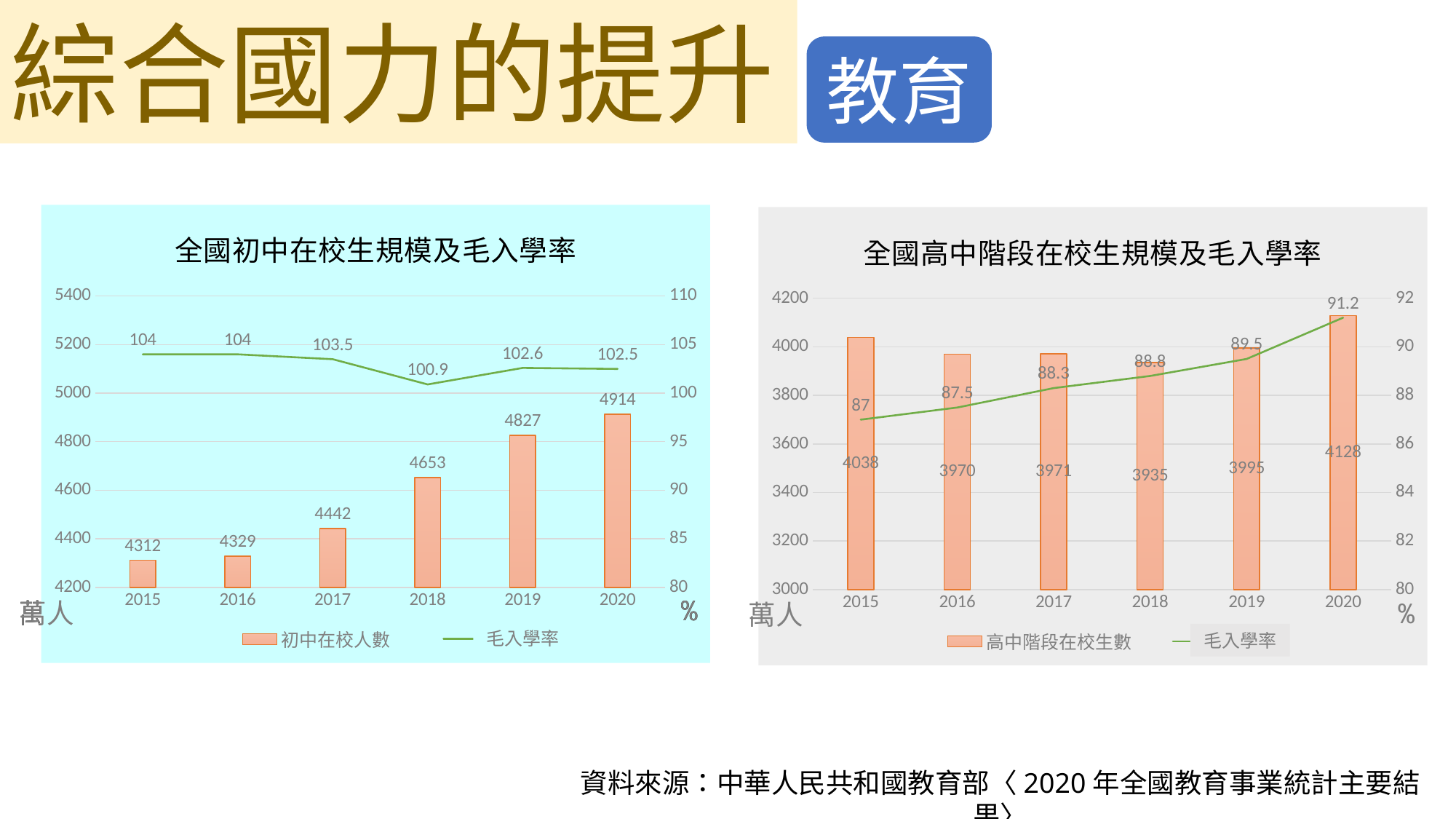
In the chart titled 全國初中在校生規模及毛入學率, what is the 毛入學率 for 2018? 100.9 In the chart titled 全國初中在校生規模及毛入學率, what is the value of 初中在校人數 for 2018? 4653 In the chart titled 全國初中在校生規模及毛入學率, which year has the highest 初中在校人數? 2020 In the chart titled 全國高中階段在校生規模及毛入學率, which year has the lowest 高中階段在校生數? 2018 In the chart titled 全國初中在校生規模及毛入學率, do the 初中在校人數 bars rise or fall from 2015 to 2020? rise In the chart titled 全國高中階段在校生規模及毛入學率, which is larger, the 高中階段在校生數 for 2015 or for 2019? 2015 In the chart titled 全國初中在校生規模及毛入學率, how many series does the legend list? 2 In the chart titled 全國高中階段在校生規模及毛入學率, what is the difference in 毛入學率 between 2020 and 2015? 4.2 In the chart titled 全國初中在校生規模及毛入學率, what is the difference in 初中在校人數 between 2020 and 2015? 602 In the chart titled 全國高中階段在校生規模及毛入學率, how many years are shown on the x axis? 6 In the chart titled 全國高中階段在校生規模及毛入學率, what is the 毛入學率 for 2017? 88.3 In the chart titled 全國高中階段在校生規模及毛入學率, what is the 高中階段在校生數 for 2020? 4128